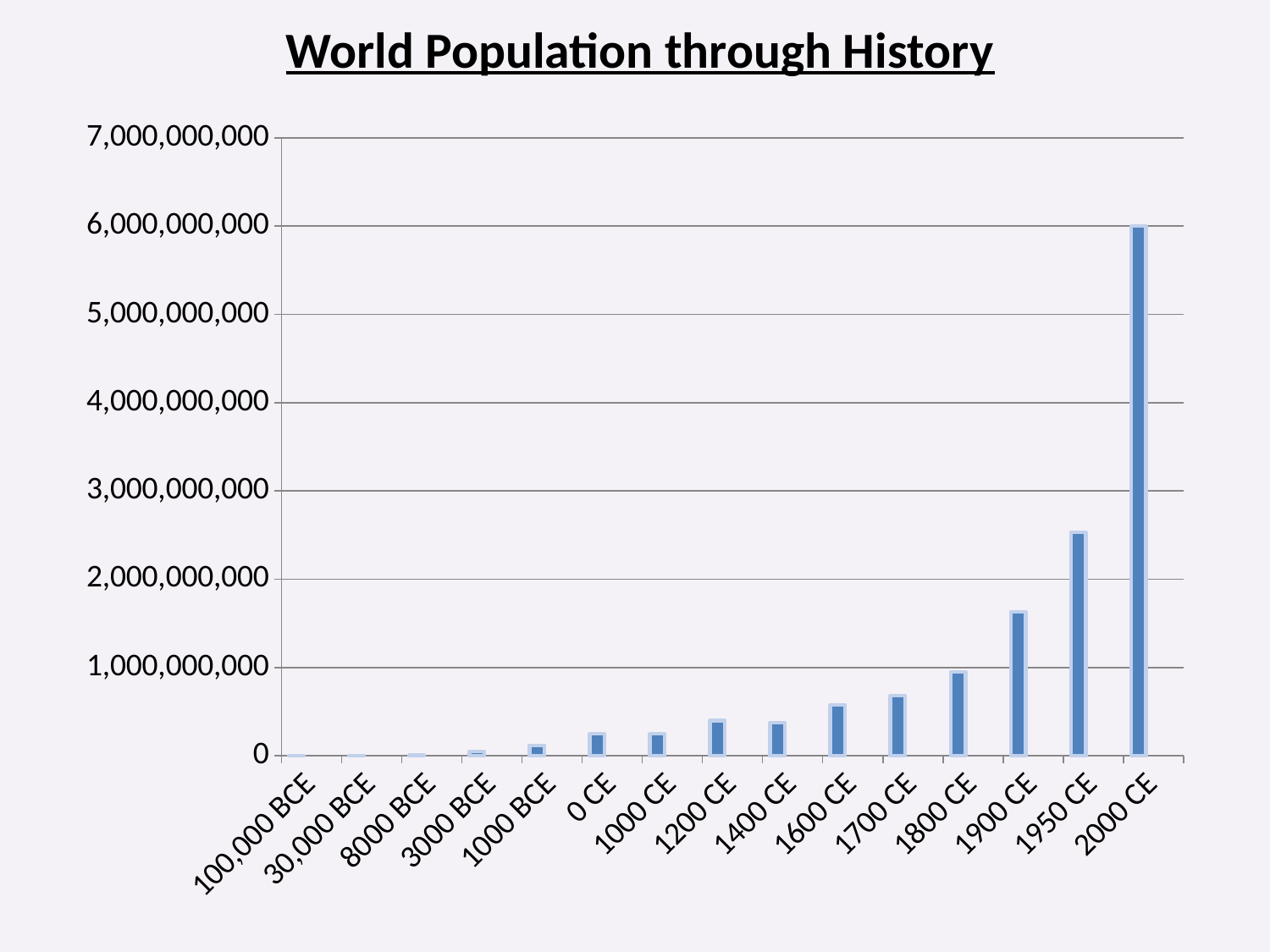
Do the values generally rise or fall moving from left to right along the x axis? rise Is the value for 1900 CE greater or less than 1,000,000,000? greater Which has a larger value, 1950 CE or 1900 CE? 1950 CE What is the title of the chart? World Population through History Is the value for 1700 CE greater or less than 1,000,000,000? less Which has a larger value, 1600 CE or 1400 CE? 1600 CE Which time period has the highest world population? 2000 CE Is the value for 2000 CE greater or less than 5,000,000,000? greater What kind of chart is shown on the slide? bar chart How many categories (time periods) are shown on the x axis? 15